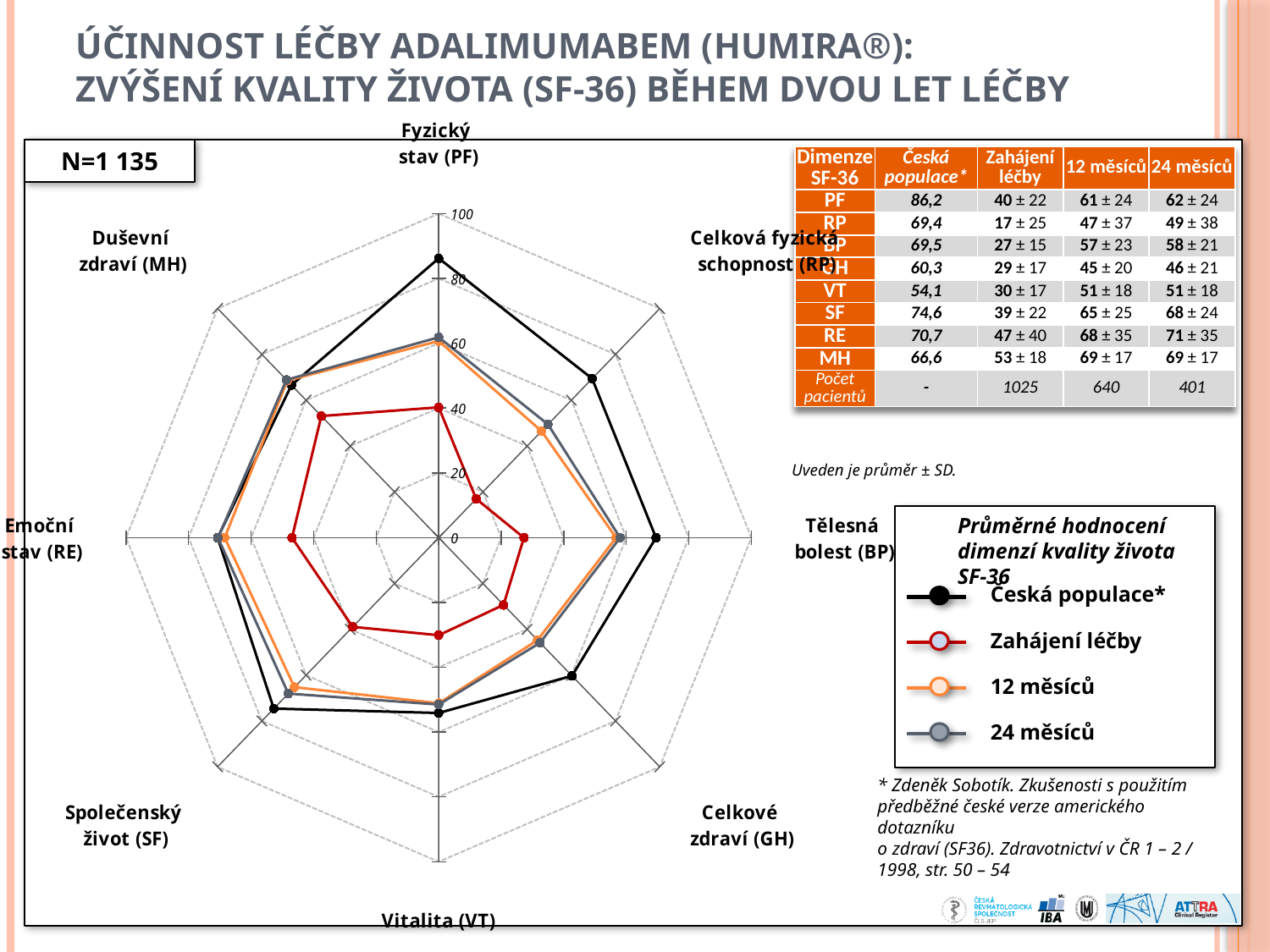
Which is larger on the PF dimension: Česká populace or Zahájení léčby? Česká populace What is the difference between the 24 měsíců and 12 měsíců mean values on the RP dimension? 2 Which dimension has the lowest value for the Zahájení léčby series? RP What is the maximum value shown on the radar chart's radial axis? 100 What is the value for 24 měsíců on the RE dimension? 71 ± 35 What is the value for Zahájení léčby on the RP dimension? 17 ± 25 How many SF-36 dimensions (axes) does the radar chart have? 8 What kind of chart is shown on the slide? radar chart How many series does the chart legend list? 4 Is the value for Zahájení léčby on the PF dimension greater or less than 60? less What is the value for Česká populace on the PF dimension? 86,2 Which dimension has the highest value for the Česká populace series? PF